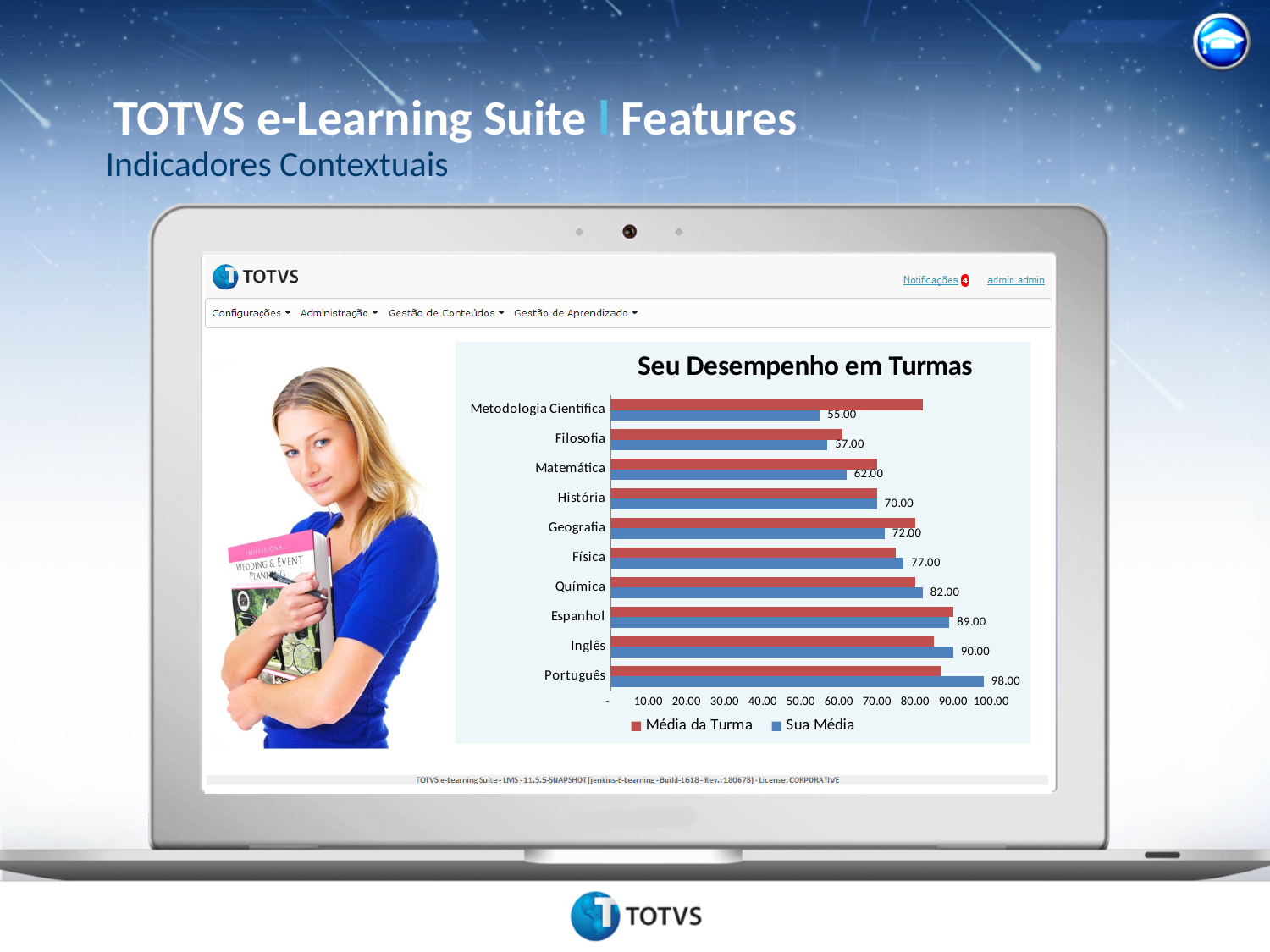
What is the title of the chart? Seu Desempenho em Turmas Which category has the highest Sua Média value? Português What is the Sua Média value for Português? 98.00 How many categories are shown on the chart? 10 Which category has the lowest Sua Média value? Metodologia Científica Is the Média da Turma value for Filosofia greater or less than 70.00? less Which has a larger Sua Média value, Física or História? Física What is the Sua Média value for Metodologia Científica? 55.00 How many series does the legend list? 2 What is the Sua Média value for Geografia? 72.00 What is the difference between the Sua Média values for Inglês and Química? 8.00